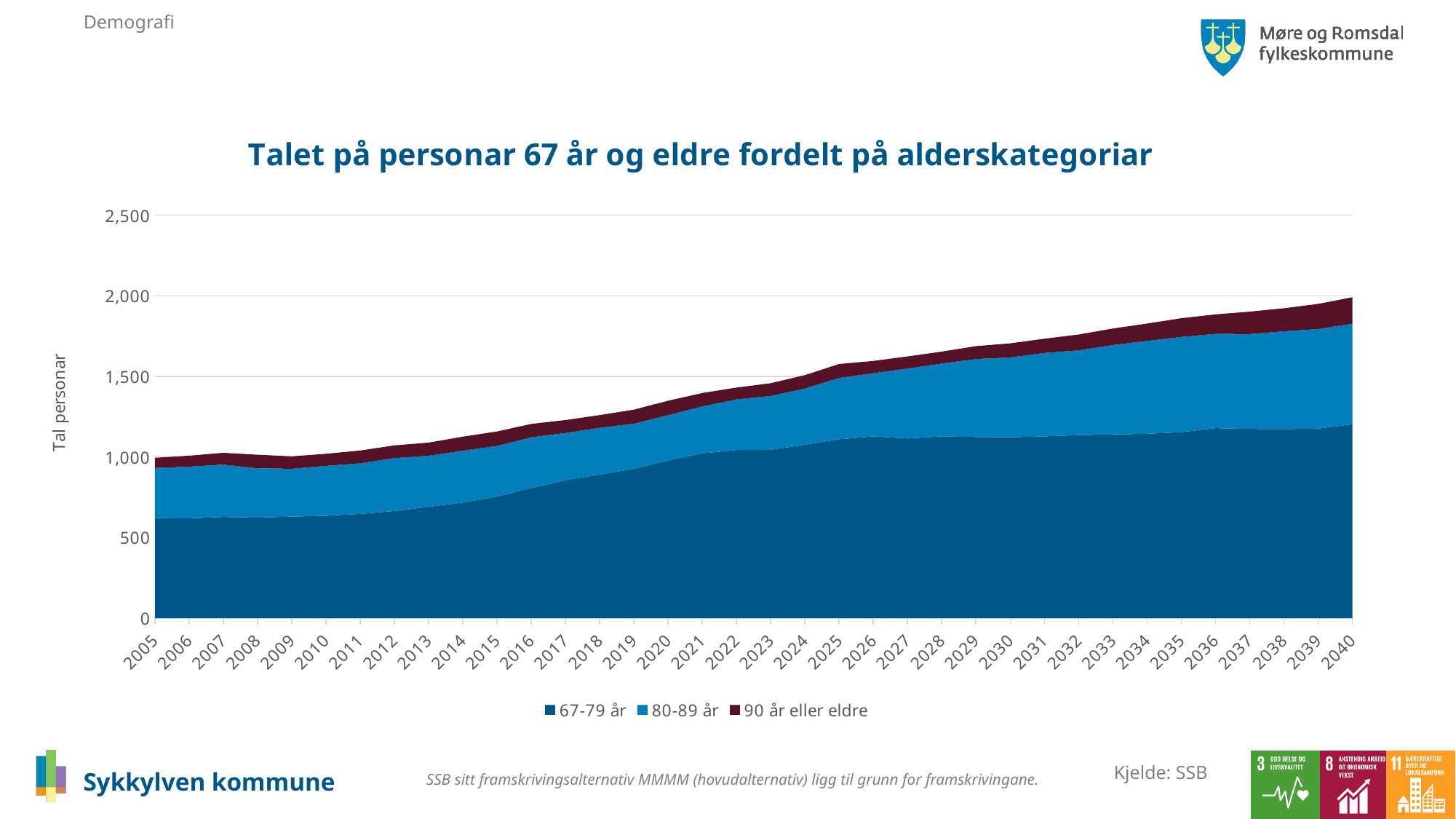
Which age category has the largest number of persons in 2040? 67-79 år What is the title of the chart? Talet på personar 67 år og eldre fordelt på alderskategoriar What kind of chart is shown on the slide? Stacked area chart Is the total of all age categories in 2030 greater or less than 2,000? less Is the value for the 67-79 år series in 2040 greater or less than 1,000? greater What is the label on the y axis? Tal personar Is the total of all age categories in 2020 greater or less than 1,500? less How many series does the legend list? 3 How many years are shown along the x axis? 36 Does the total number of persons 67 years and older rise or fall from 2005 to 2040? Rise